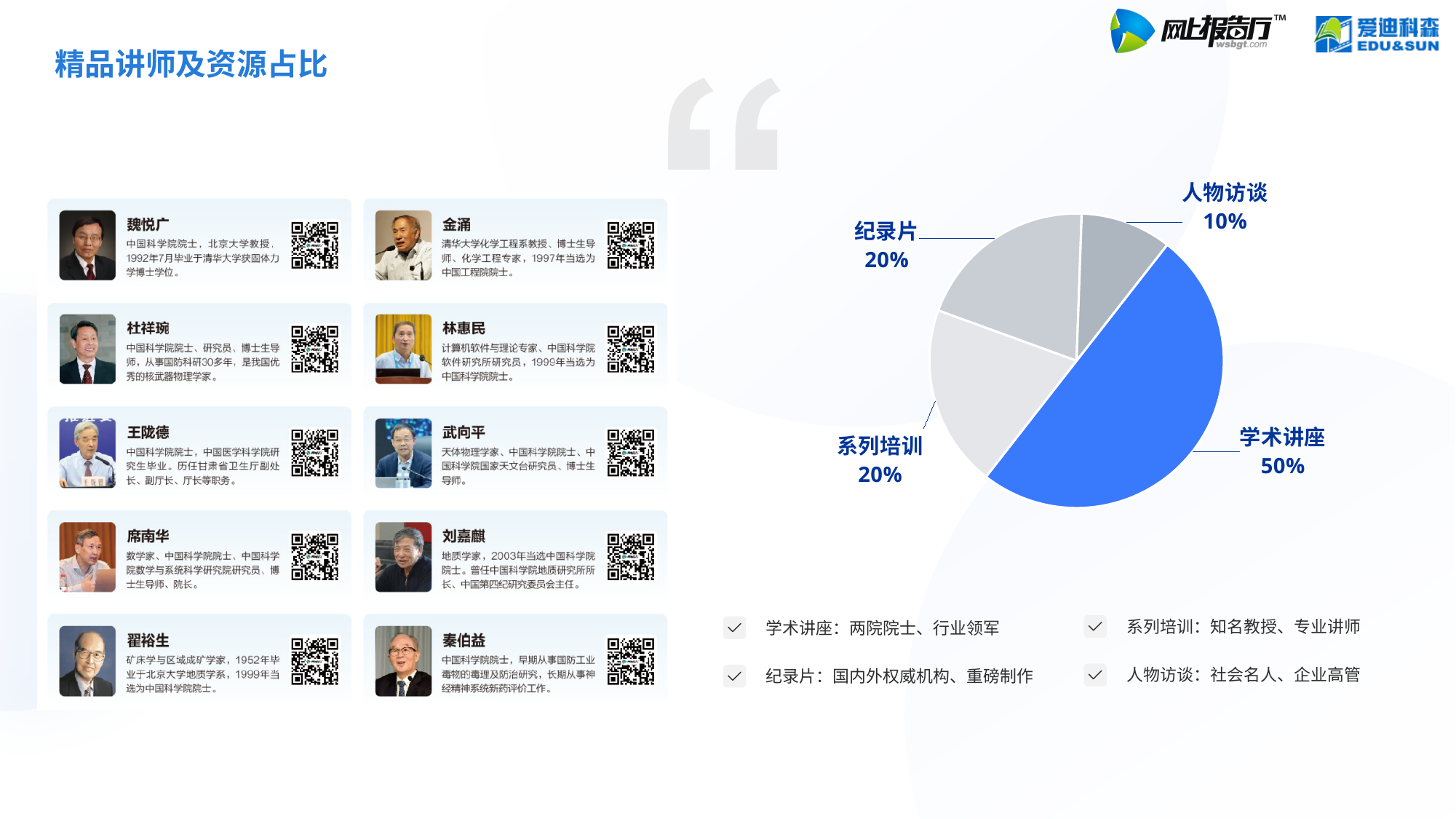
Which category has the smallest slice of the pie? 人物访谈 What is the value shown for 系列培训? 20% What kind of chart is shown on the slide? pie chart What is the combined share of 纪录片 and 系列培训? 40% How many slices does the pie chart have? 4 What share of the pie does 学术讲座 account for? 50% What is the value shown for 人物访谈? 10% Which category has the largest slice of the pie? 学术讲座 What is the difference in percentage points between 学术讲座 and 人物访谈? 40 What colour is the 学术讲座 slice of the pie? blue What is the value shown for 纪录片? 20% Which is larger, the slice for 纪录片 or the slice for 人物访谈? 纪录片